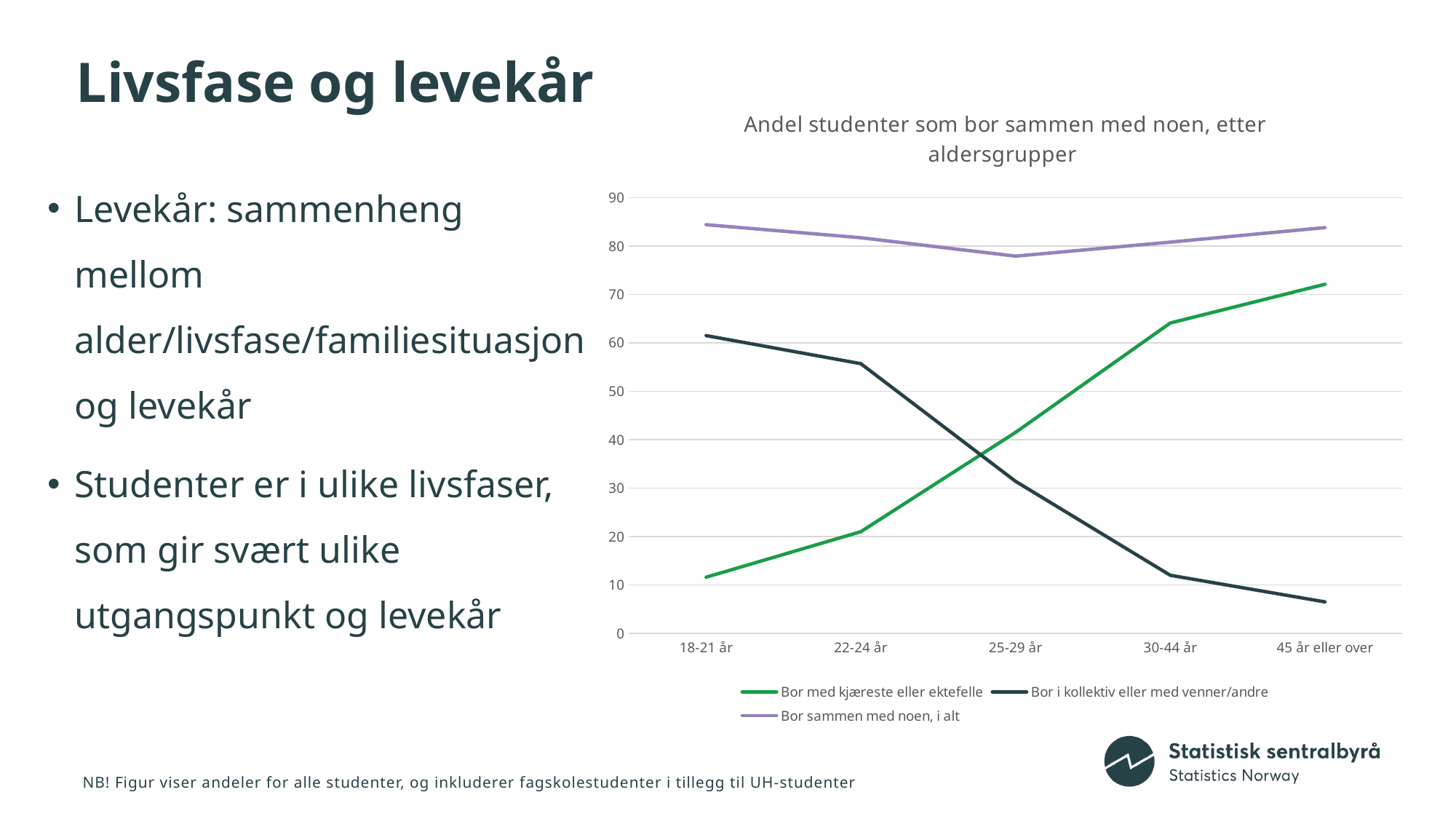
For which age group is the value of 'Bor sammen med noen, i alt' lowest? 25-29 år In the 22-24 år group, which is larger: 'Bor med kjæreste eller ektefelle' or 'Bor i kollektiv eller med venner/andre'? Bor i kollektiv eller med venner/andre Is the value for 'Bor med kjæreste eller ektefelle' in the 18-21 år group greater or less than 20? less Is the value for 'Bor i kollektiv eller med venner/andre' in the 18-21 år group greater or less than 50? greater Does the line for 'Bor med kjæreste eller ektefelle' rise or fall as age increases along the x axis? rises How many age groups are shown on the x axis of the chart? 5 What is the title of the chart? Andel studenter som bor sammen med noen, etter aldersgrupper How many series does the chart's legend list? 3 For which age group is the value of 'Bor med kjæreste eller ektefelle' highest? 45 år eller over Does the line for 'Bor i kollektiv eller med venner/andre' rise or fall as age increases along the x axis? falls What kind of chart is shown on the slide? line chart For which age group is the value of 'Bor i kollektiv eller med venner/andre' lowest? 45 år eller over